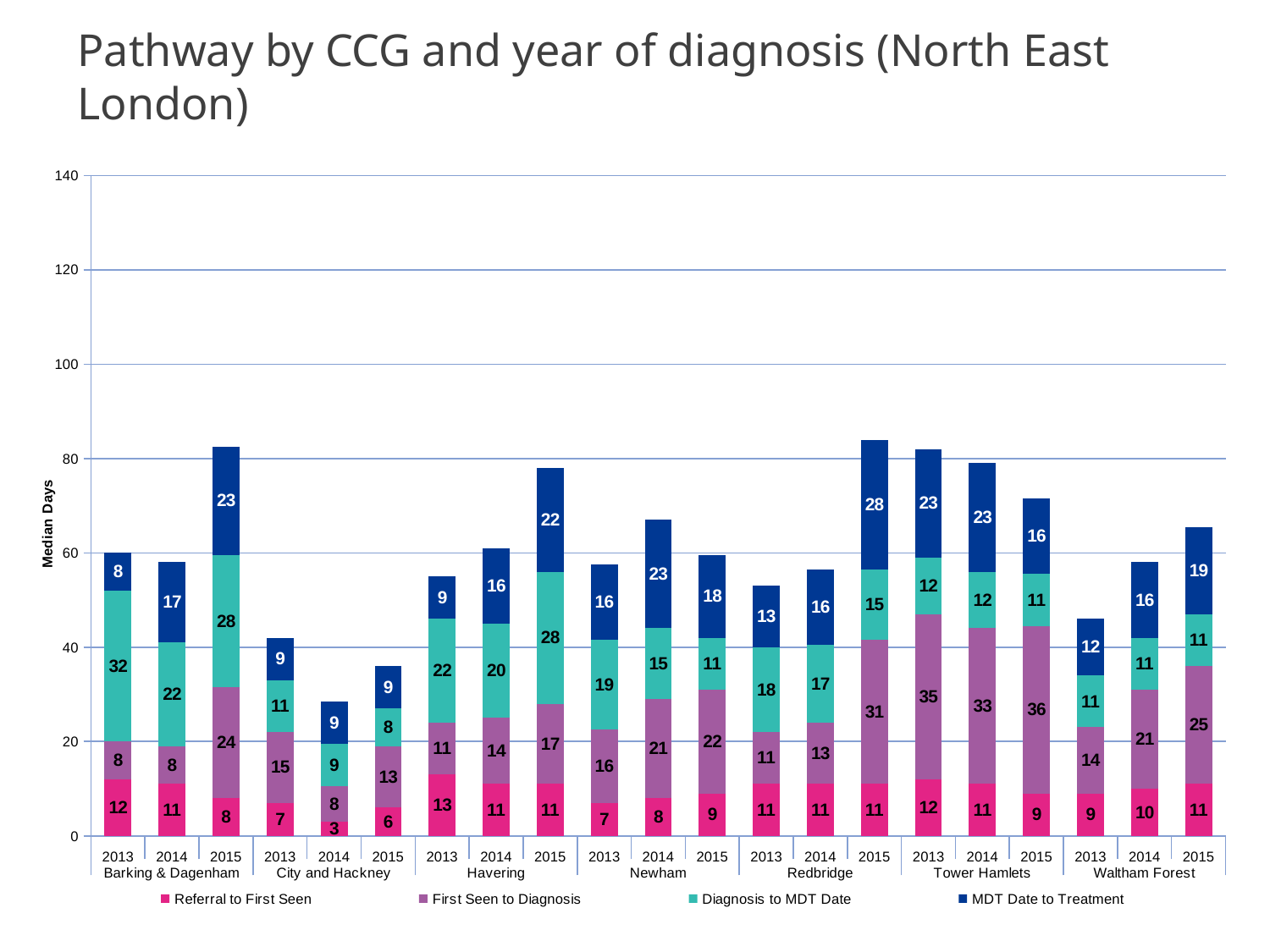
How many series does the legend list? 4 What is the Referral to First Seen value for City and Hackney in 2014? 3 Which CCG and year has the lowest total median days? City and Hackney 2014 What kind of chart is shown on the slide? Stacked bar chart Is the total for Barking & Dagenham 2015 greater or less than 80? greater Which CCG and year has the highest Diagnosis to MDT Date value? Barking & Dagenham 2013 How many CCGs are shown along the x axis? 7 What is the difference between the First Seen to Diagnosis value for Tower Hamlets 2015 and Waltham Forest 2013? 22 Which is larger, the Diagnosis to MDT Date value for Barking & Dagenham 2013 or for Havering 2015? Barking & Dagenham 2013 What is the MDT Date to Treatment value for Redbridge in 2015? 28 What is the total of the stacked bar for City and Hackney in 2014? 29 What is the Referral to First Seen value for Tower Hamlets in 2013? 12